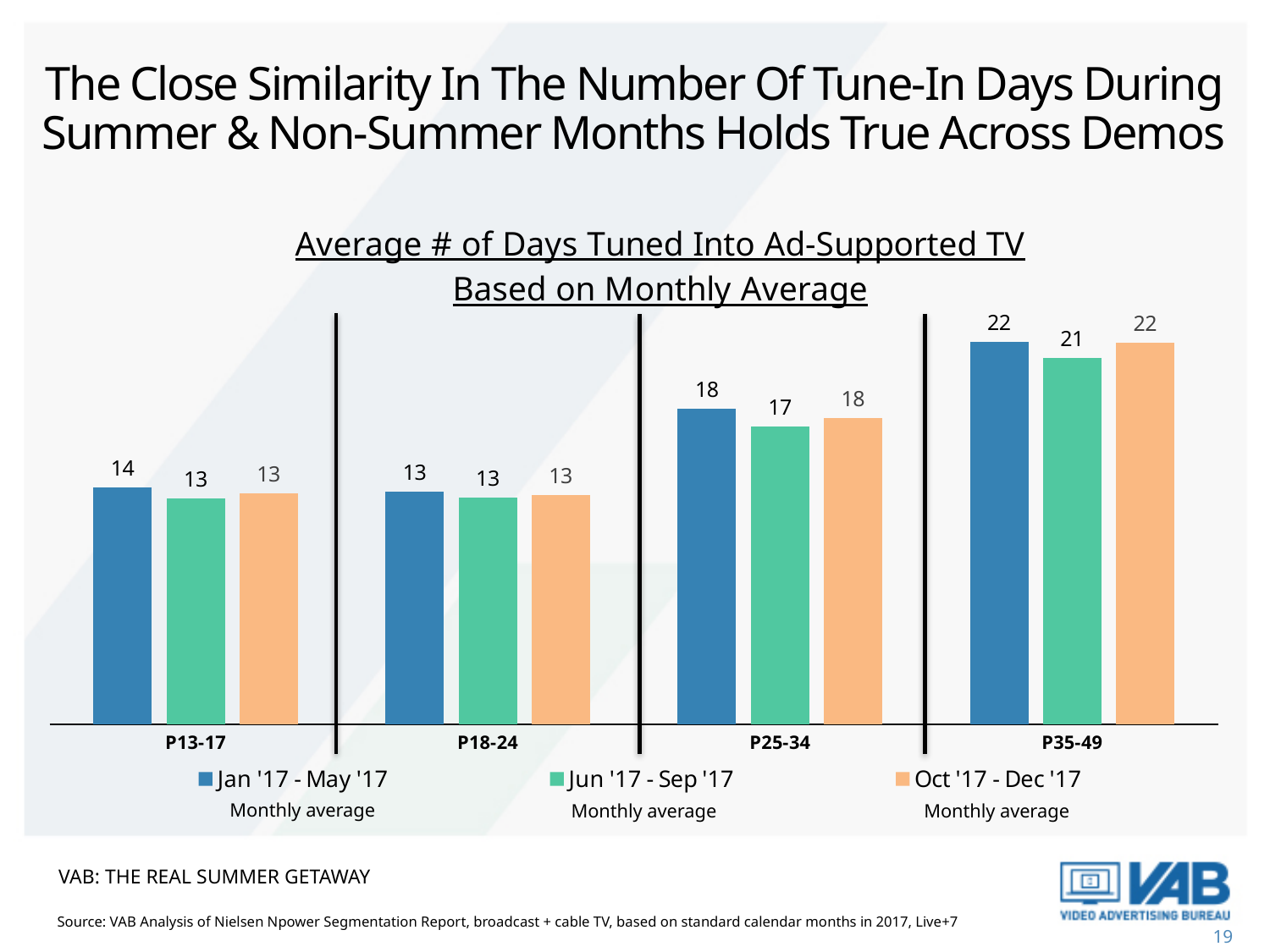
What is the value for P13-17 in the Jan '17 - May '17 series? 14 What is the difference between the P35-49 and P25-34 values in the Oct '17 - Dec '17 series? 4 Which is larger: the Jan '17 - May '17 value for P25-34 or the Jan '17 - May '17 value for P18-24? P25-34 What kind of chart is shown on the slide? Bar chart What is the title of the chart? Average # of Days Tuned Into Ad-Supported TV Based on Monthly Average What is the value for P25-34 in the Jun '17 - Sep '17 series? 17 How many demo categories are shown on the x axis? 4 How many series does the legend list? 3 What is the value for P35-49 in the Oct '17 - Dec '17 series? 22 What is the difference between the Jan '17 - May '17 and Jun '17 - Sep '17 values for P35-49? 1 Which demo has the highest value in the Jan '17 - May '17 series? P35-49 Which demo has the lowest value in the Jun '17 - Sep '17 series? P13-17 and P18-24 (both 13)